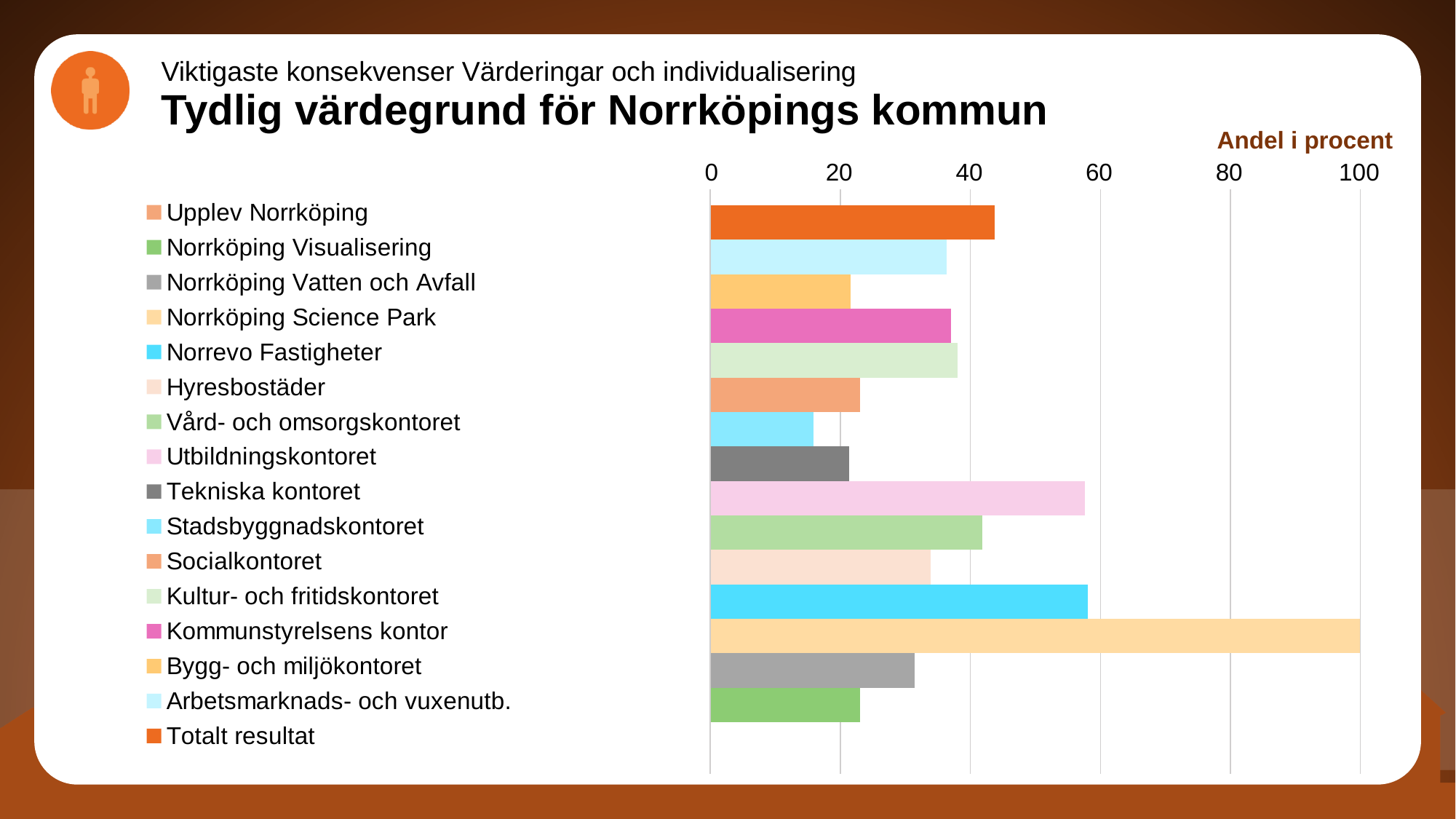
What kind of chart is shown on the slide? bar chart Is the value for Hyresbostäder greater or less than 40? less What label is shown above the horizontal axis of the chart? Andel i procent Which is larger, the value for Norrevo Fastigheter or the value for Stadsbyggnadskontoret? Norrevo Fastigheter How many entries does the chart legend list? 16 Is the value for Stadsbyggnadskontoret greater or less than 20? less Is the value for Norrköping Vatten och Avfall greater or less than 20? greater Which is larger, the value for Totalt resultat or the value for Hyresbostäder? Totalt resultat What is the value for Norrköping Science Park? 100 Which category has the longest bar in the chart? Norrköping Science Park